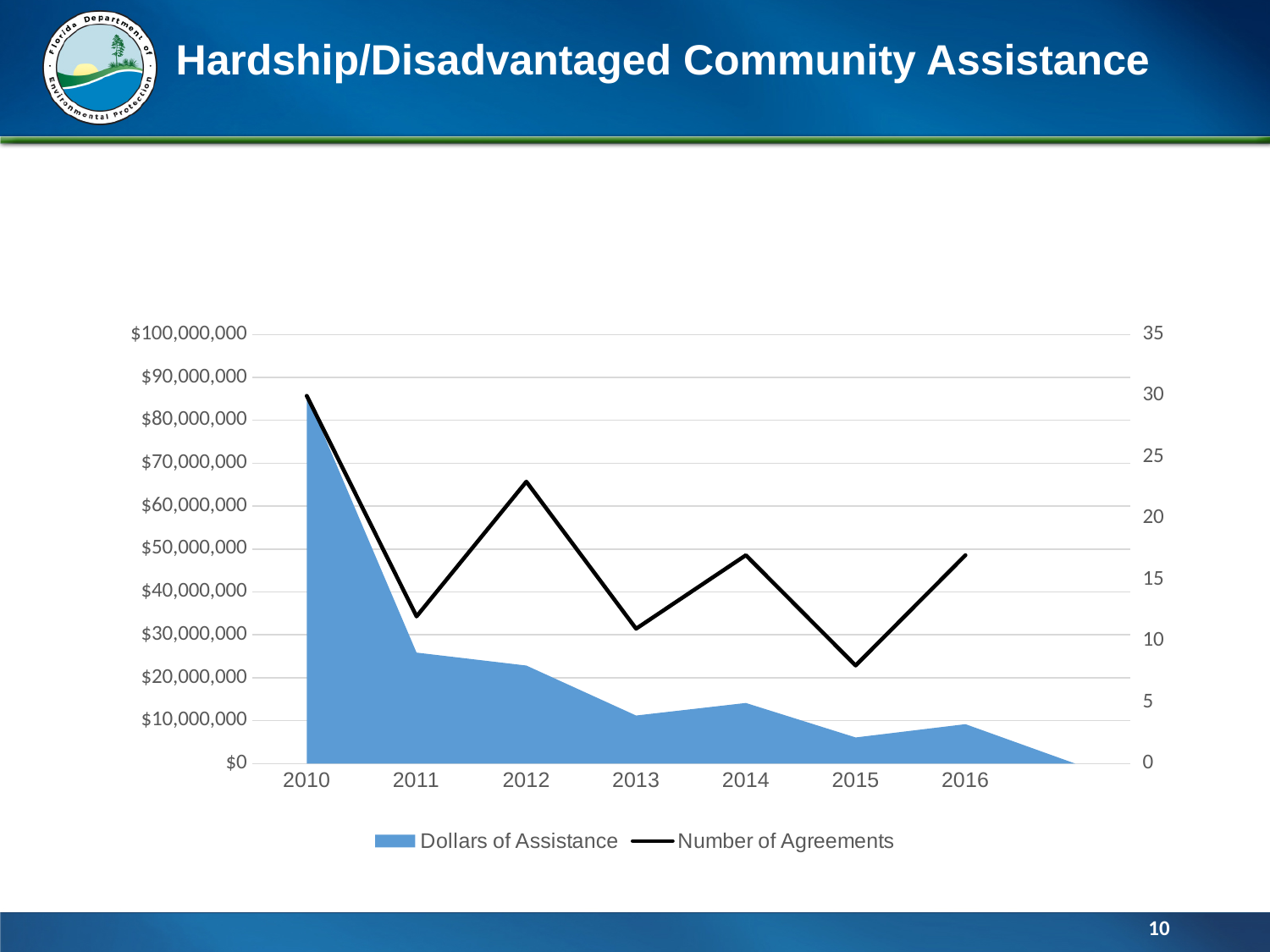
Which year has the highest Number of Agreements? 2010 Is the Dollars of Assistance value for 2011 greater or less than $30,000,000? less Is the Number of Agreements for 2012 greater or less than 20? greater Does the Dollars of Assistance value generally rise or fall from 2010 to 2016? fall Which year has more agreements, 2011 or 2012? 2012 Which series is drawn as a black line? Number of Agreements How many series does the legend list? 2 Which year has the highest value for Dollars of Assistance? 2010 Which year has a higher Dollars of Assistance value, 2011 or 2014? 2011 Is the Number of Agreements for 2015 greater or less than 10? less Which year has the lowest Number of Agreements? 2015